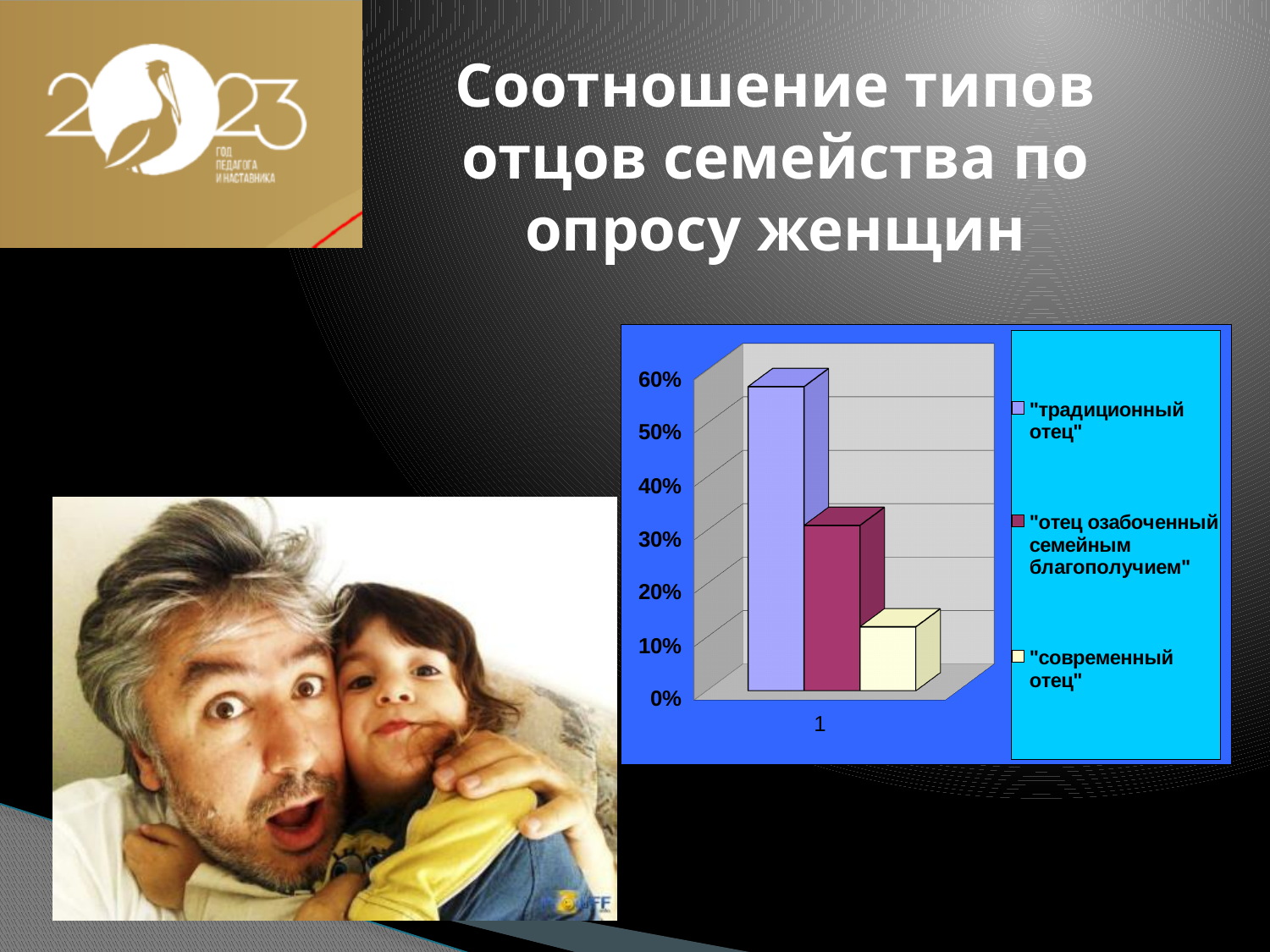
What is the highest value shown on the chart's vertical axis? 60% Which type of father has the lowest value in the chart? "современный отец" How many series does the chart legend list? 3 What kind of chart is shown on the slide? bar chart Which type of father has the highest value in the chart? "традиционный отец" What colour is the bar for "современный отец"? light yellow Which is larger: the value for "традиционный отец" or the value for "отец озабоченный семейным благополучием"? "традиционный отец" Which is larger: the value for "отец озабоченный семейным благополучием" or the value for "современный отец"? "отец озабоченный семейным благополучием" Is the value for "традиционный отец" greater or less than 50%? greater Is the value for "отец озабоченный семейным благополучием" greater or less than 40%? less Is the value for "современный отец" greater or less than 20%? less